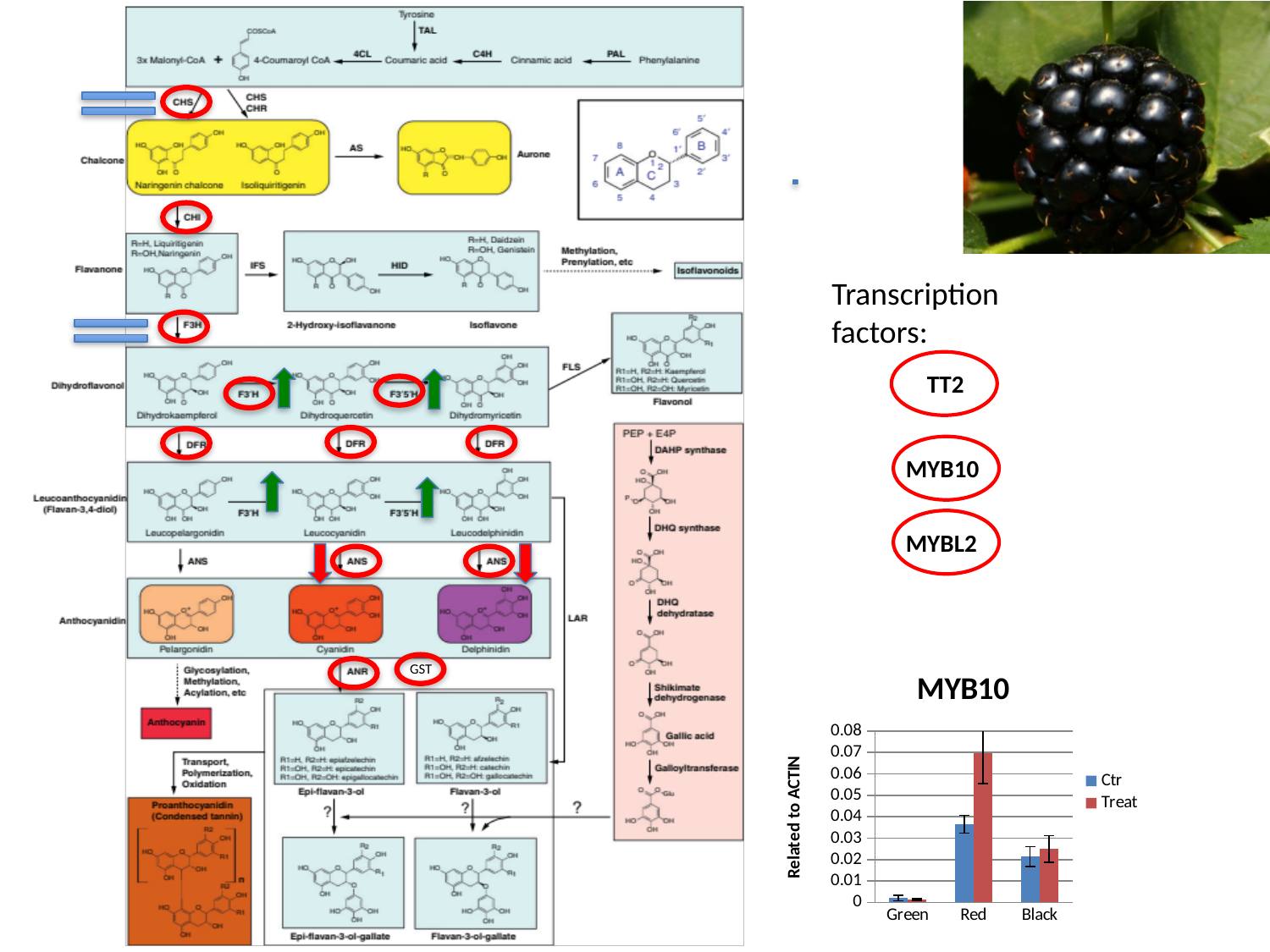
In the MYB10 chart, is the Treat value for Red greater or less than 0.06? greater How many series does the legend of the MYB10 chart list? 2 How many categories are shown on the x axis of the MYB10 chart? 3 What are the two series named in the legend of the MYB10 chart? Ctr and Treat In the MYB10 chart, which is larger: the Ctr value for Red or the Ctr value for Black? Red In the MYB10 chart, which is larger for Red: the Ctr value or the Treat value? Treat In the MYB10 chart, is the Ctr value for Green greater or less than 0.01? less In the MYB10 chart, which category has the highest Treat value? Red What is the y-axis title of the MYB10 chart? Related to ACTIN In the MYB10 chart, which category has the lowest Ctr value? Green What kind of chart is the MYB10 chart? bar chart In the MYB10 chart, is the Ctr value for Red greater or less than 0.03? greater